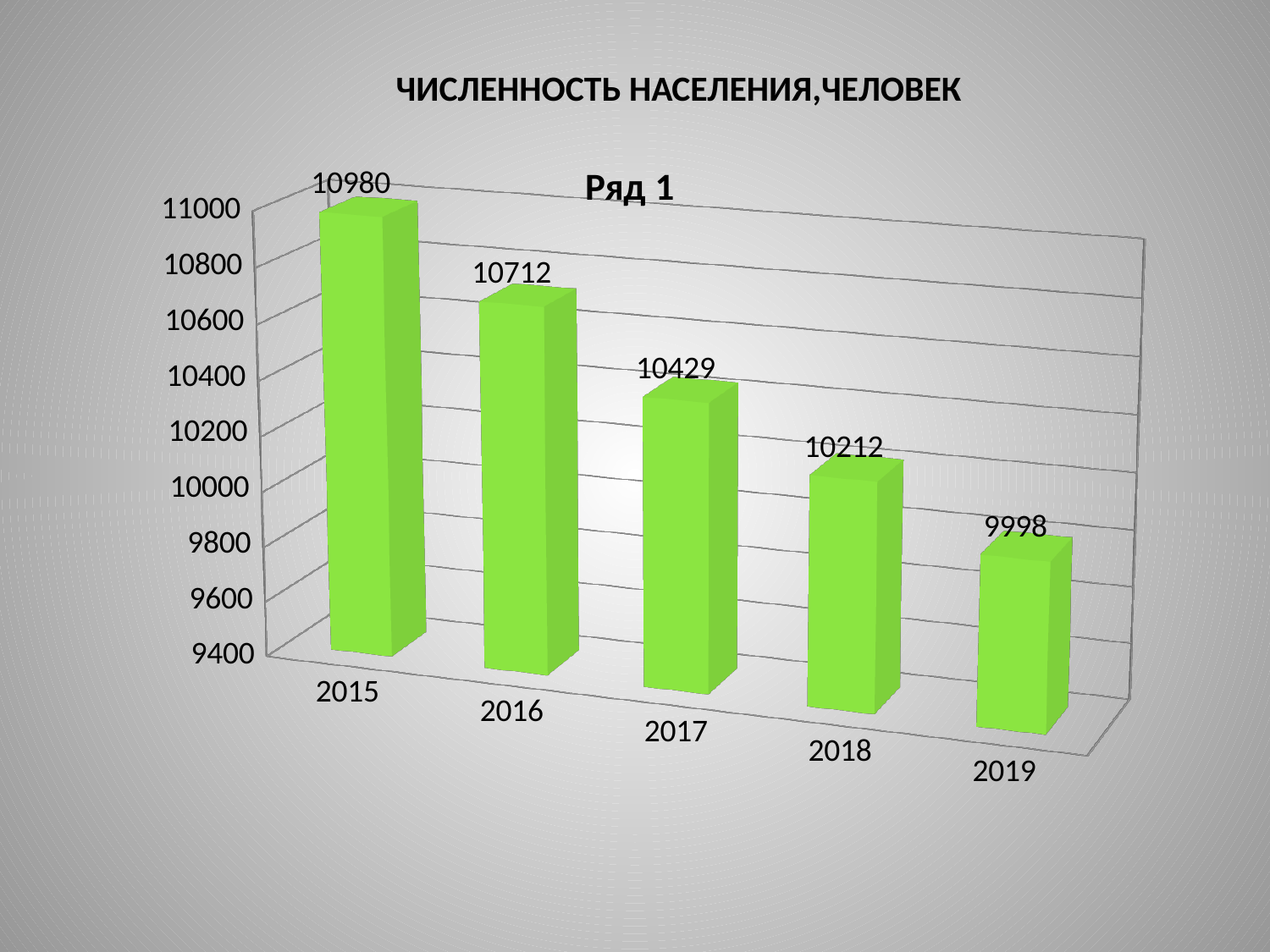
Which is larger, the value for 2018 or the value for 2019? 2018 What is the difference between the values for 2015 and 2019? 982 What is the population value for 2019? 9998 Which year has the highest population value? 2015 What is the population value for 2015? 10980 What kind of chart is shown on the slide? bar chart Do the values rise or fall from 2015 to 2019? fall Which year has the lowest population value? 2019 What is the difference between the values for 2016 and 2017? 283 What is the population value for 2017? 10429 How many years are shown on the x axis? 5